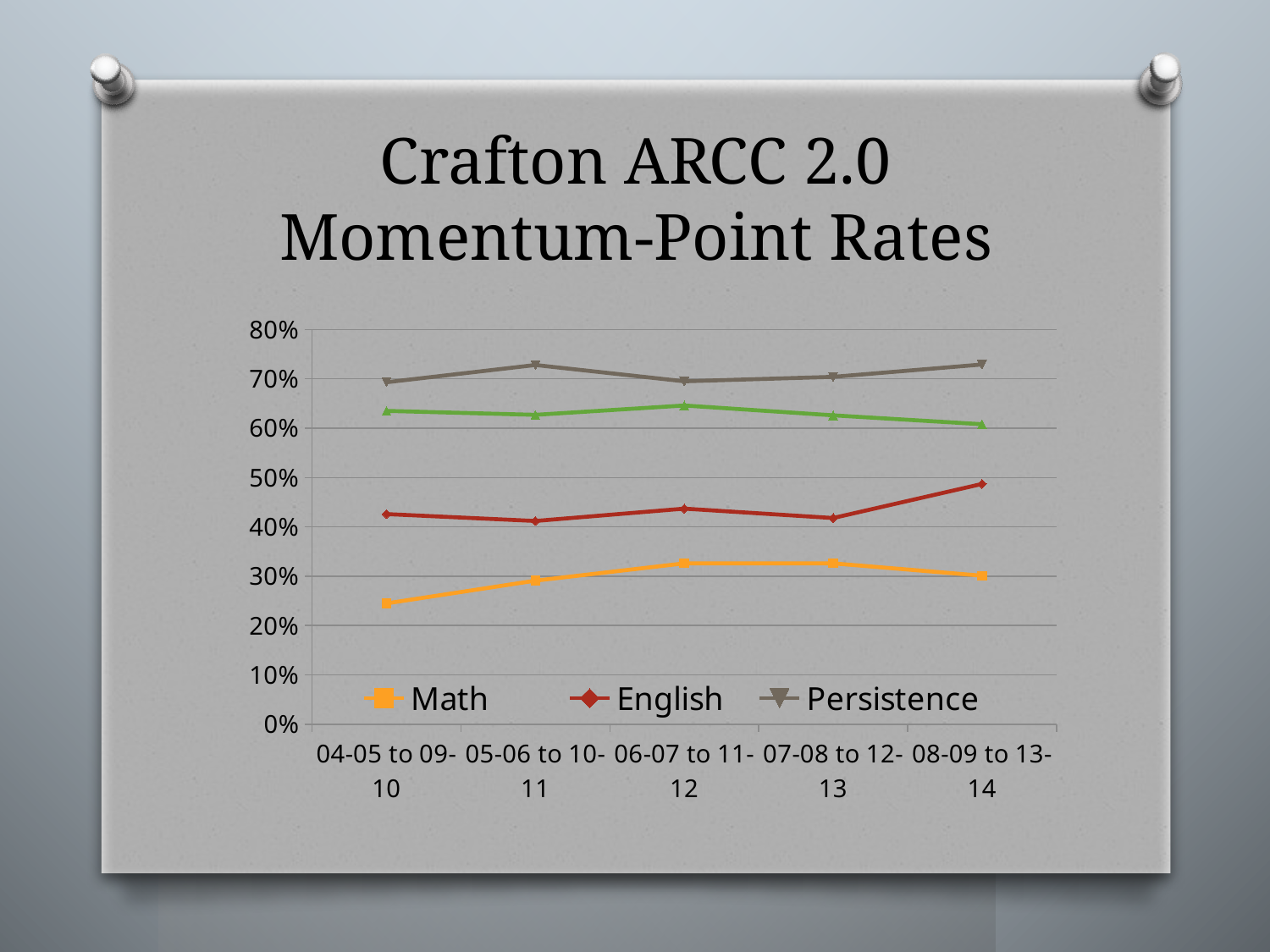
Which cohort period has the highest English value? 08-09 to 13-14 Is the Math value for 04-05 to 09-10 greater or less than 30%? less How many cohort periods are shown on the x axis? 5 For 08-09 to 13-14, which is larger, the English value or the Math value? English Does the Math value rise or fall from 04-05 to 09-10 to 05-06 to 10-11? Rise What is the title of the chart slide? Crafton ARCC 2.0 Momentum-Point Rates Is the Math value for 06-07 to 11-12 greater or less than 30%? greater What kind of chart is shown on the slide? Line chart Is the English value for 08-09 to 13-14 greater or less than 40%? greater How many series does the chart legend list? 3 Which cohort period has the lowest Math value? 04-05 to 09-10